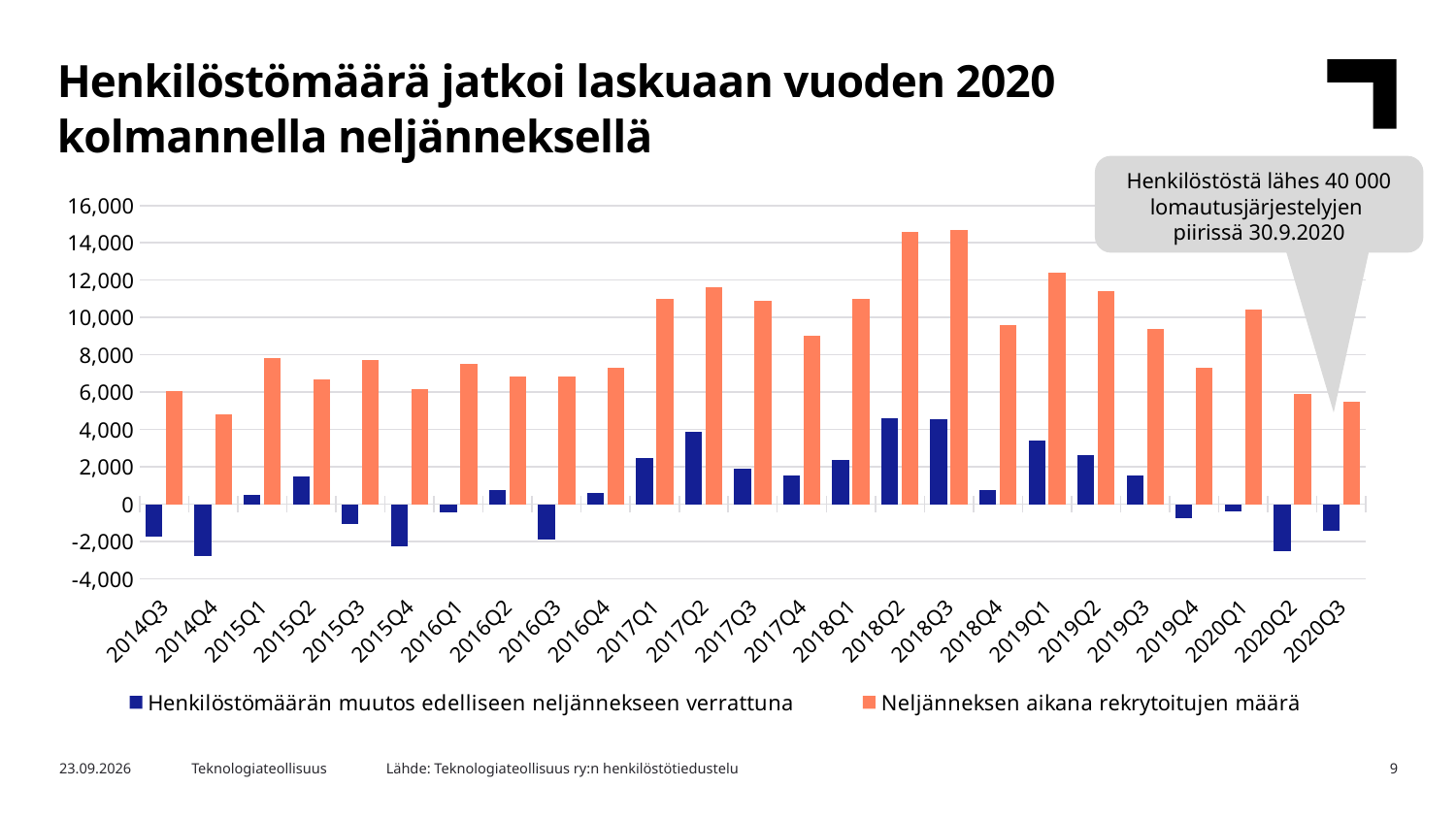
Do the values for Neljänneksen aikana rekrytoitujen määrä generally rise or fall from 2018Q3 to 2020Q3? fall What does the callout on the chart say about the number of staff under lay-off arrangements on 30.9.2020? Henkilöstöstä lähes 40 000 lomautusjärjestelyjen piirissä 30.9.2020 How many quarters are shown on the x axis? 25 Which quarter has the lowest value for Neljänneksen aikana rekrytoitujen määrä? 2014Q4 Is the value for Henkilöstömäärän muutos edelliseen neljännekseen verrattuna in 2020Q2 greater or less than -2,000? less Which is larger for Henkilöstömäärän muutos edelliseen neljännekseen verrattuna: 2017Q2 or 2017Q3? 2017Q2 How many series does the legend list? 2 Is the value for Neljänneksen aikana rekrytoitujen määrä in 2020Q3 greater or less than 6,000? less Is the value for Henkilöstömäärän muutos edelliseen neljännekseen verrattuna in 2018Q2 greater or less than 4,000? greater What kind of chart is shown on the slide? bar chart Which is larger for Neljänneksen aikana rekrytoitujen määrä: 2019Q1 or 2019Q2? 2019Q1